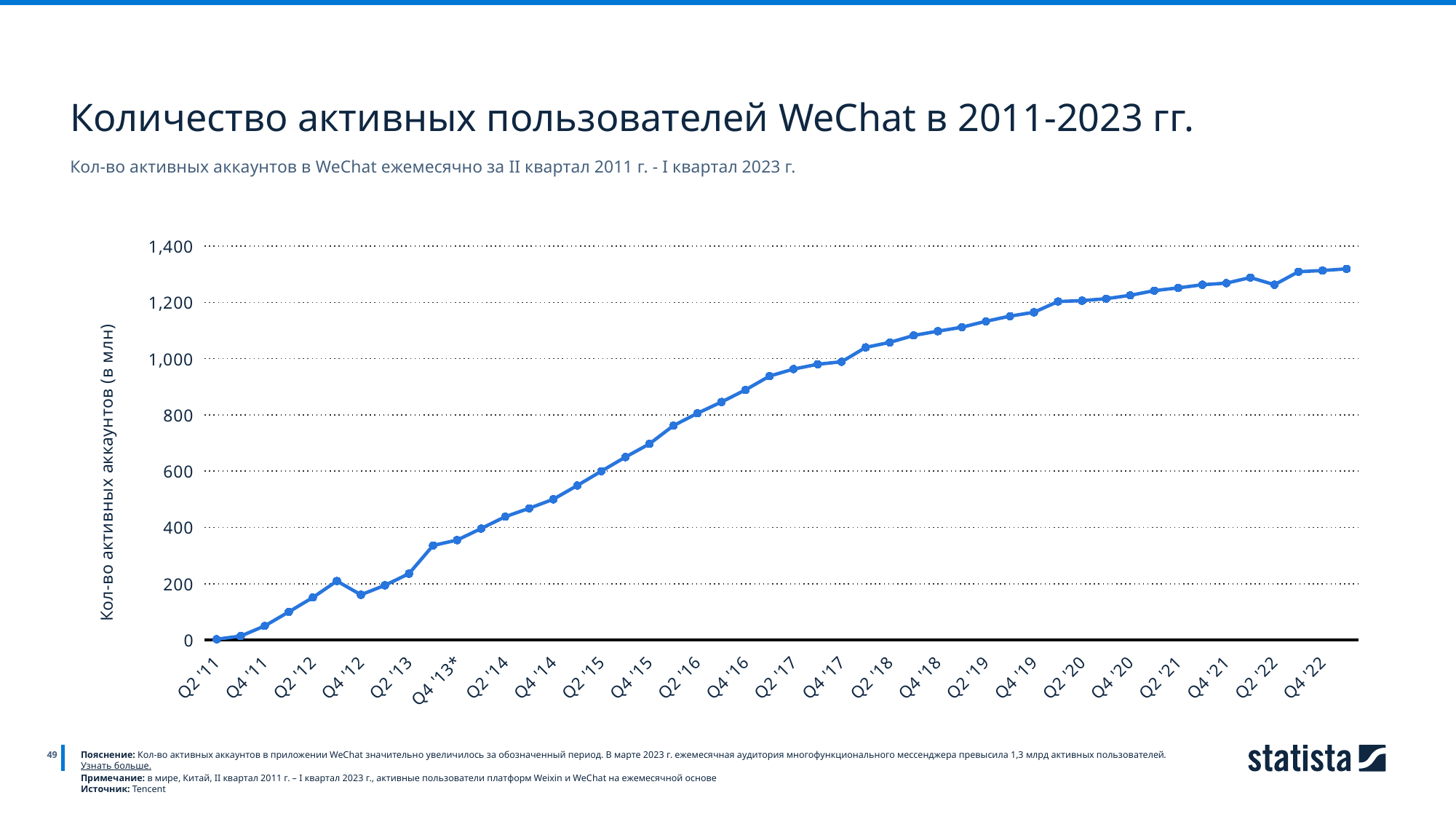
Is the value for Q4 '19 greater or less than 1,200? less Which labelled quarter has the lowest number of active accounts? Q2 '11 Which is larger, the value for Q4 '12 or the value for Q2 '13? Q2 '13 Is the value for Q4 '16 greater or less than 1,000? less Is the highest value of the series at the beginning or at the end of the x axis? end Is the value for Q4 '12 greater or less than 200? less What is the label of the y axis? Кол-во активных аккаунтов (в млн) Do the values generally rise or fall from Q2 '11 to the end of the series? rise What kind of chart is shown on the slide? line chart